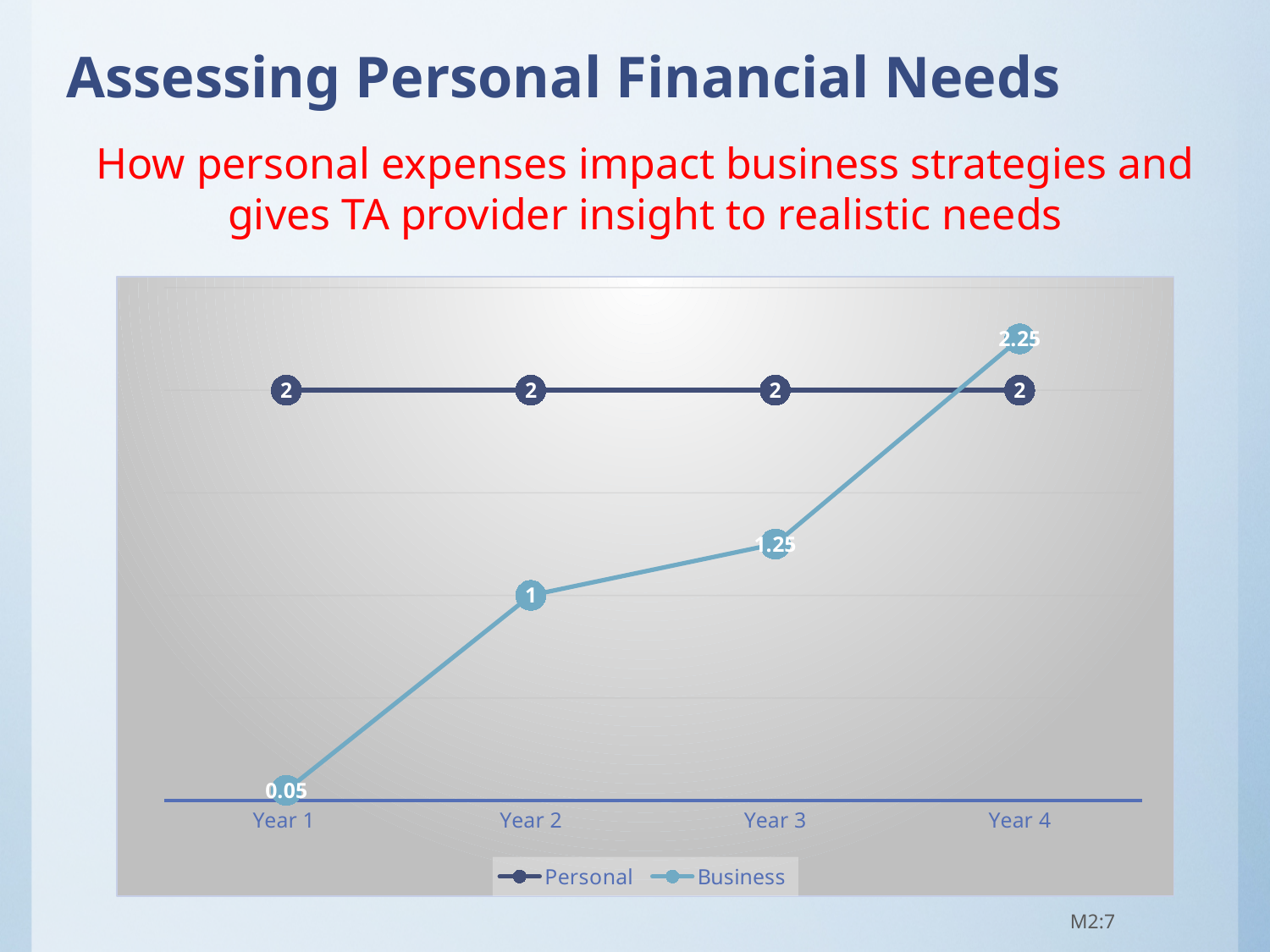
Does the Business series rise or fall from Year 1 to Year 4? rise What type of chart is shown on the slide? line chart In which year is the Business value lowest? Year 1 What is the value for Business in Year 3? 1.25 What is the value for Personal in Year 2? 2 What is the difference between the Business value in Year 4 and the Business value in Year 3? 1 How many categories are shown on the x axis? 4 What are the two series named in the legend? Personal and Business Which is larger in Year 4, the Personal value or the Business value? Business In which year is the Business value highest? Year 4 How many series does the legend list? 2 What is the value for Business in Year 1? 0.05